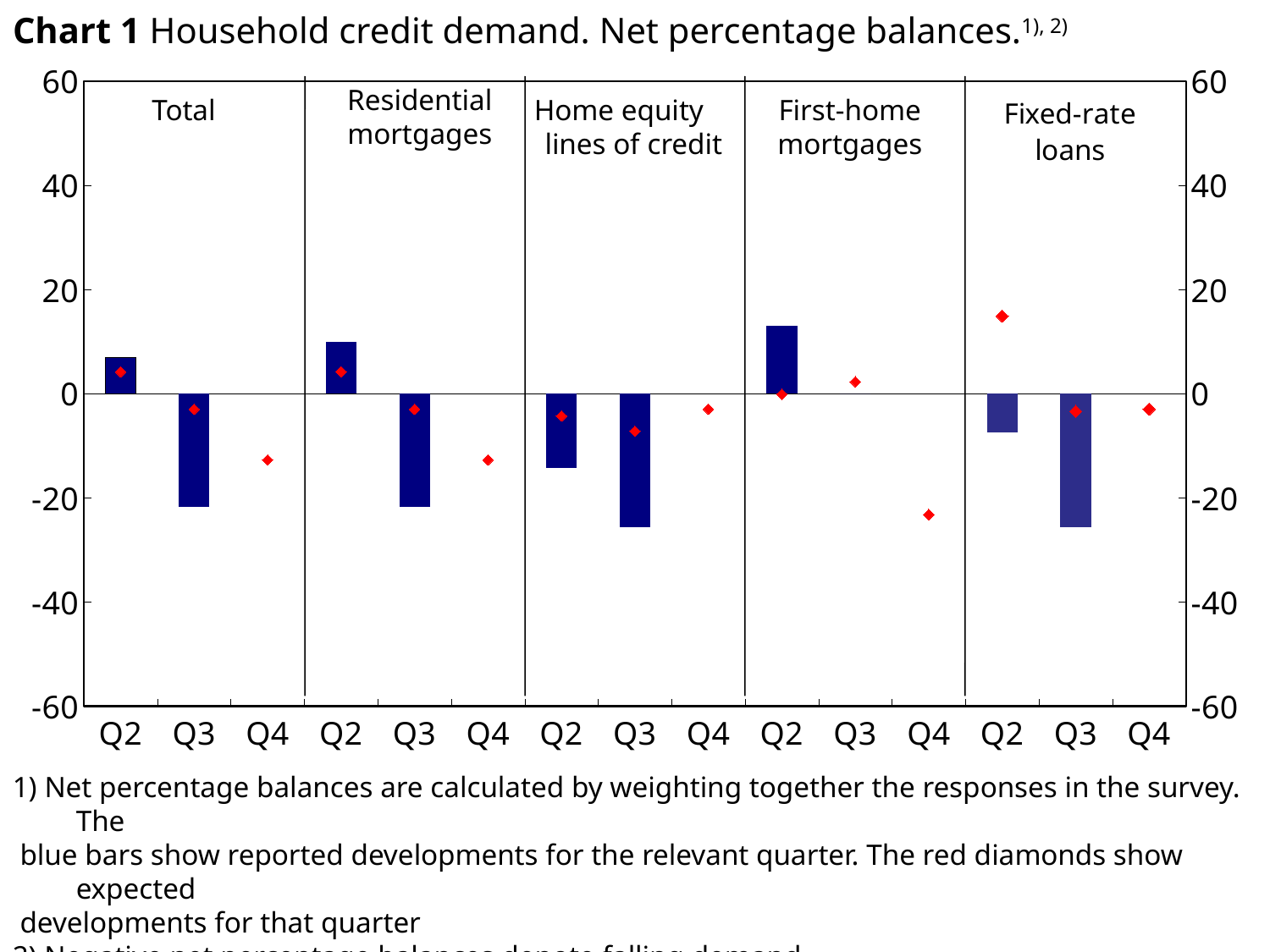
Is the Q2 bar for First-home mortgages greater or less than 20? less Is the Q2 red diamond for Fixed-rate loans greater or less than 20? less In which panels is the Q2 bar negative? Home equity lines of credit and Fixed-rate loans How many credit categories (panels) are shown in Chart 1? 5 How many quarters are shown on the x axis within each panel of Chart 1? 3 Is the Q3 bar for Home equity lines of credit greater or less than -20? less Do the Total bars rise or fall from Q2 to Q3? fall What kind of chart is Chart 1? bar chart According to the footnote, what do the red diamonds show? Expected developments for that quarter Which is larger, the Q2 bar for Total or the Q2 bar for First-home mortgages? First-home mortgages Which panel has the highest Q2 bar? First-home mortgages